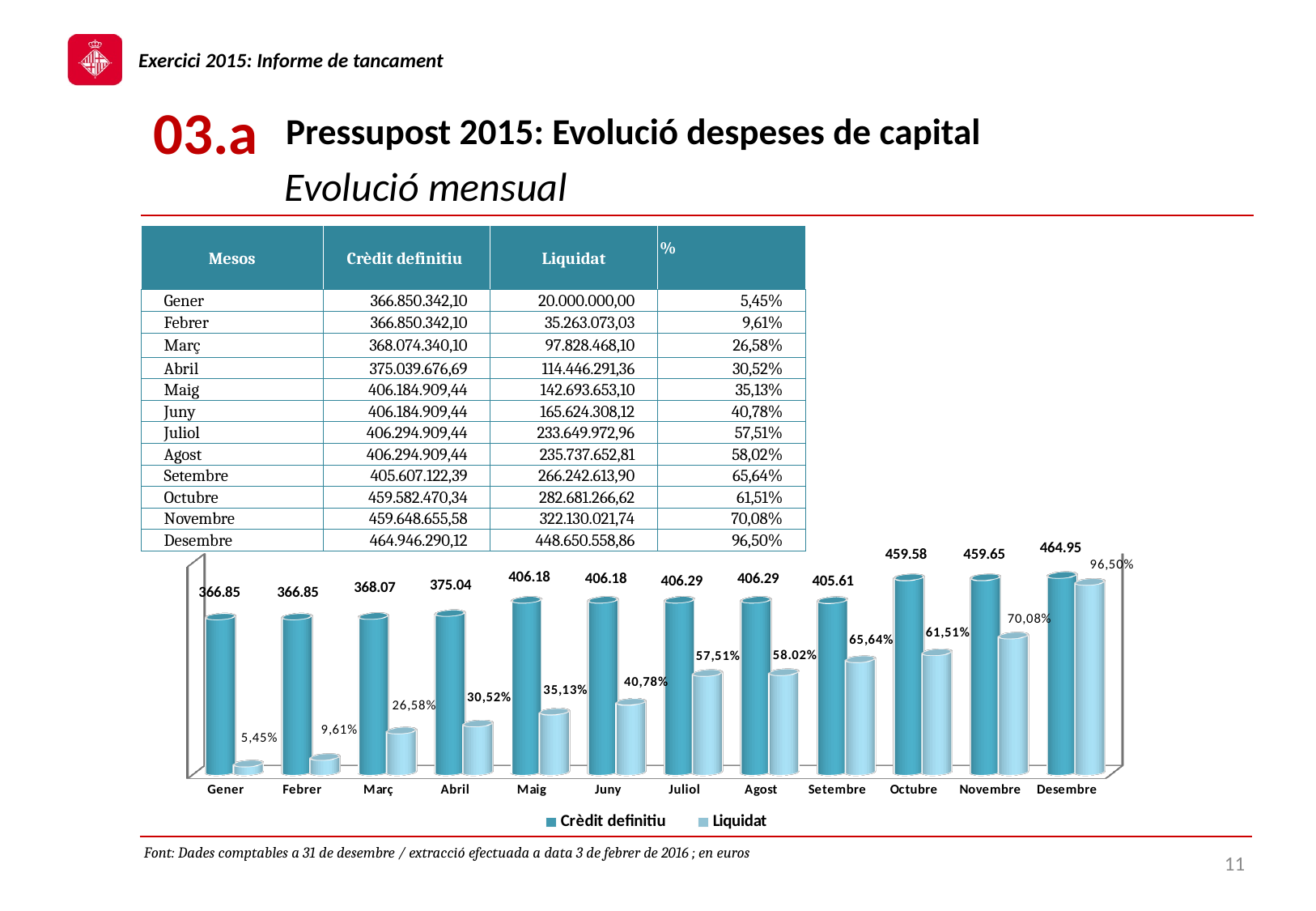
What Liquidat percentage does the chart show for Juliol? 57,51% Which month has the highest Crèdit definitiu value in the chart? Desembre How many series does the chart legend list? 2 Do the Liquidat percentages generally rise or fall from Gener to Desembre in the chart? Rise What type of chart is shown on the slide? Bar chart By how many percentage points does the Liquidat value for Desembre exceed that for Novembre in the chart? 26,42% In the chart, which month has the larger Liquidat percentage, Setembre or Octubre? Setembre What is the Crèdit definitiu value labelled for Abril in the chart? 375.04 What is the Crèdit definitiu value shown for Octubre in the chart? 459.58 How many months are shown on the x axis of the chart? 12 What is the difference between the Crèdit definitiu values for Desembre and Gener in the chart? 98.10 Which month has the lowest Liquidat percentage in the chart? Gener